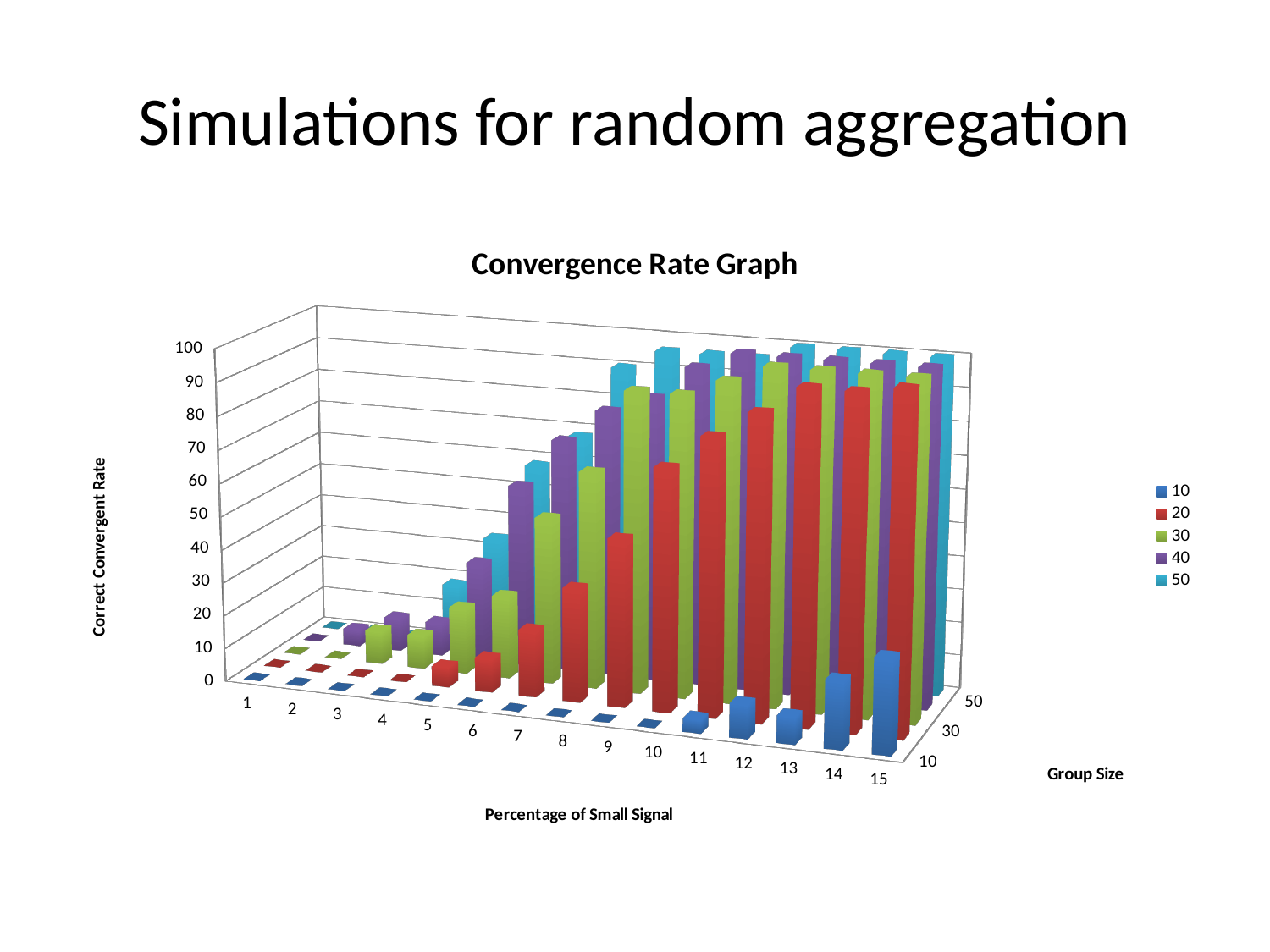
At Percentage of Small Signal 15, which series has the larger value, 10 or 50? 50 What is the label of the vertical axis? Correct Convergent Rate Do the values for the 50 series rise or fall as the Percentage of Small Signal increases from 1 to 15? rise How many categories are shown along the Percentage of Small Signal axis? 15 How many series does the legend list? 5 Which series (group size) has the lowest values overall in the chart? 10 What type of chart is shown on the slide? bar chart Is the value for the 10 series at Percentage of Small Signal 1 greater or less than 10? less Is the value for the 20 series at Percentage of Small Signal 2 greater or less than 10? less What is the title of the chart? Convergence Rate Graph Is the value for the 50 series at Percentage of Small Signal 15 greater or less than 50? greater